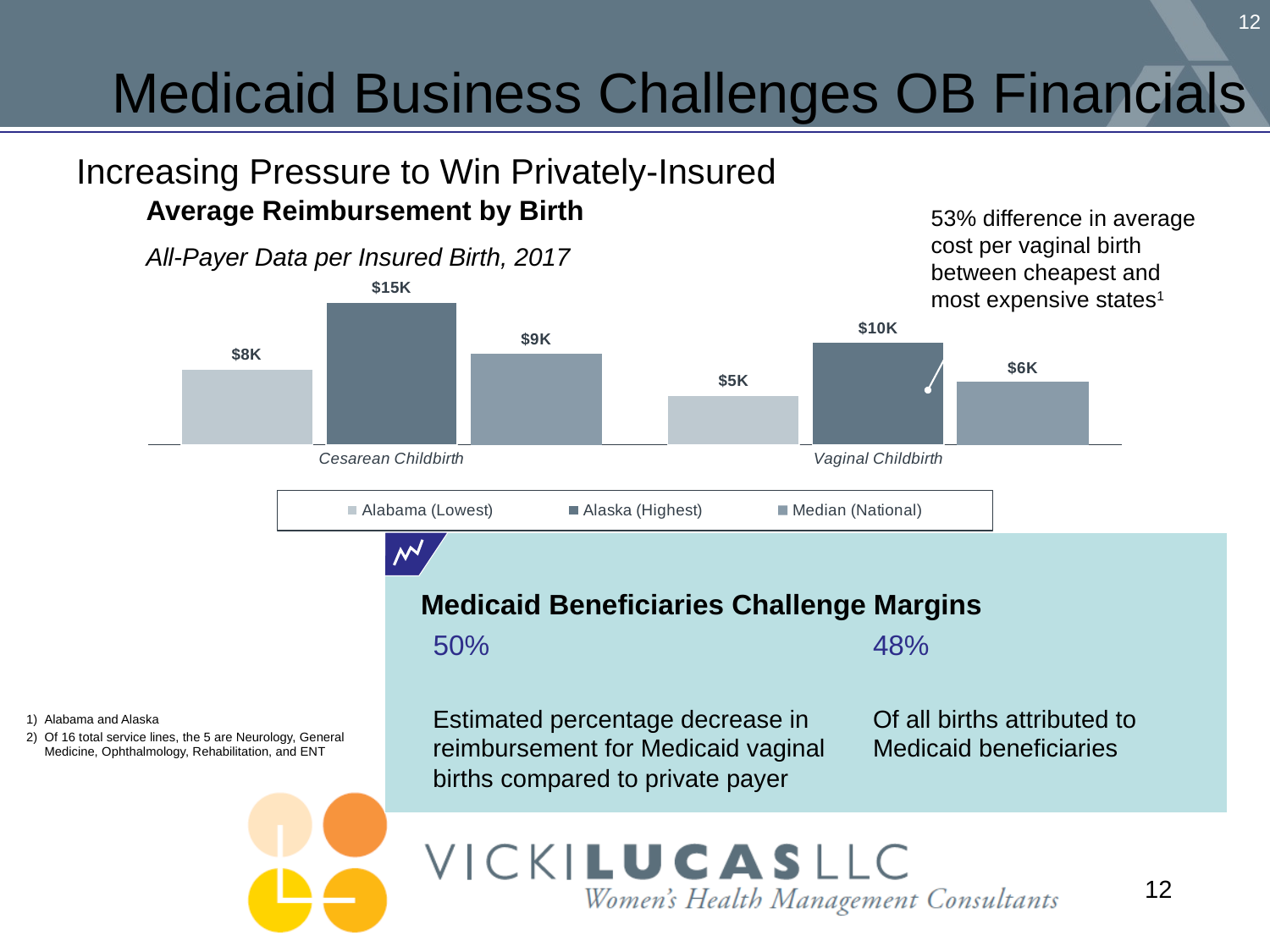
Which series has the highest reimbursement for Cesarean childbirth? Alaska (Highest) What is the difference between the Alaska (Highest) and Alabama (Lowest) reimbursement for vaginal childbirth? $5K What is the Median (National) reimbursement for a Cesarean childbirth? $9K What is the subtitle shown under the chart title 'Average Reimbursement by Birth'? All-Payer Data per Insured Birth, 2017 How many series does the chart legend list? 3 What is the average reimbursement for a vaginal childbirth in Alabama (Lowest)? $5K Which series has the lowest reimbursement for vaginal childbirth? Alabama (Lowest) What is the Median (National) reimbursement for a vaginal childbirth? $6K What kind of chart is shown on the slide? Bar chart Which is larger: the Alabama (Lowest) reimbursement for Cesarean childbirth or the Median (National) reimbursement for vaginal childbirth? Alabama (Lowest) Cesarean childbirth What is the difference between the Alaska (Highest) and Alabama (Lowest) reimbursement for Cesarean childbirth? $7K What is the average reimbursement for a Cesarean childbirth in Alaska (Highest)? $15K